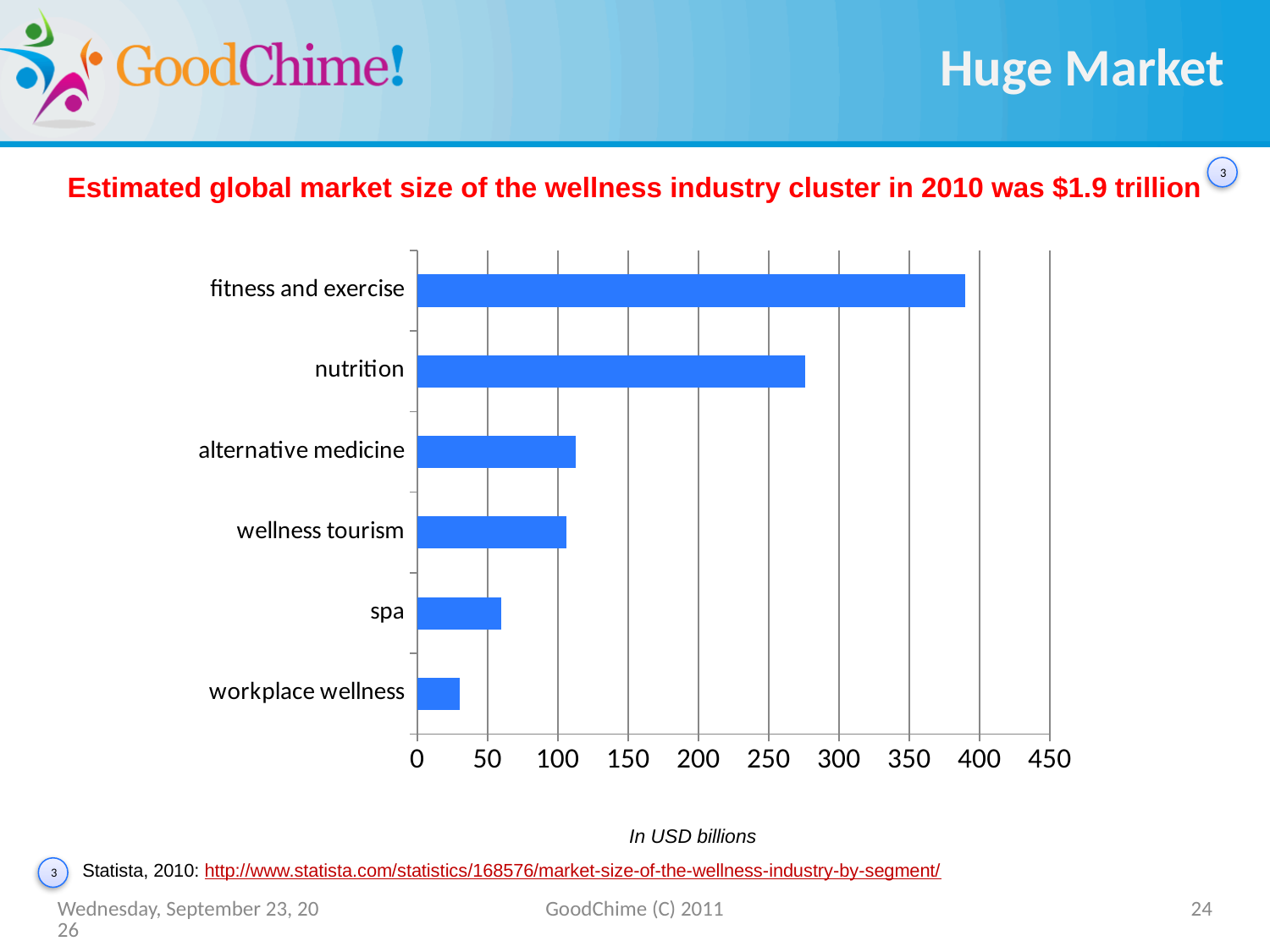
Which is larger, the value for nutrition or the value for spa? nutrition What kind of chart is shown on the slide? bar chart Which segment has the smallest market size in the chart? workplace wellness Is the value for workplace wellness greater or less than 50? less Which is larger, the value for wellness tourism or the value for workplace wellness? wellness tourism Is the value for fitness and exercise greater or less than 350? greater Is the value for nutrition greater or less than 300? less Which segment has the largest market size in the chart? fitness and exercise How many wellness industry segments are shown in the chart? 6 In what unit are the chart values expressed, according to the note below the chart? USD billions